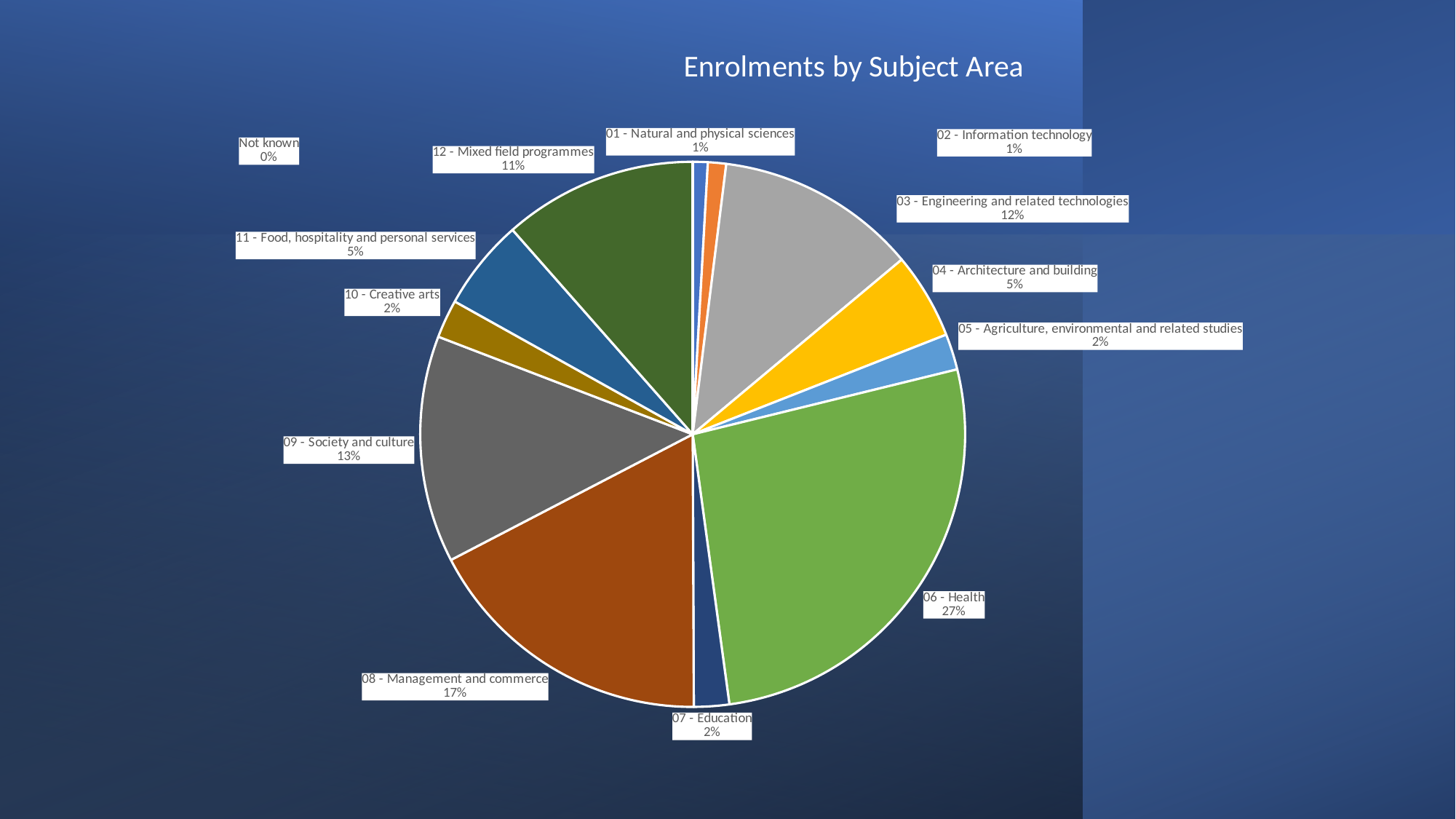
What kind of chart is shown on the slide? Pie chart Which subject area has the largest share of enrolments? 06 - Health What share of enrolments is in 06 - Health? 27% Which has a larger share of enrolments, 09 - Society and culture or 03 - Engineering and related technologies? 09 - Society and culture What share of enrolments is in 12 - Mixed field programmes? 11% What is the difference in percentage points between 06 - Health and 08 - Management and commerce? 10 Which subject area has the smallest share of enrolments? Not known What share of enrolments is in 08 - Management and commerce? 17% What is the title of the chart? Enrolments by Subject Area How many subject area categories are shown in the pie chart? 13